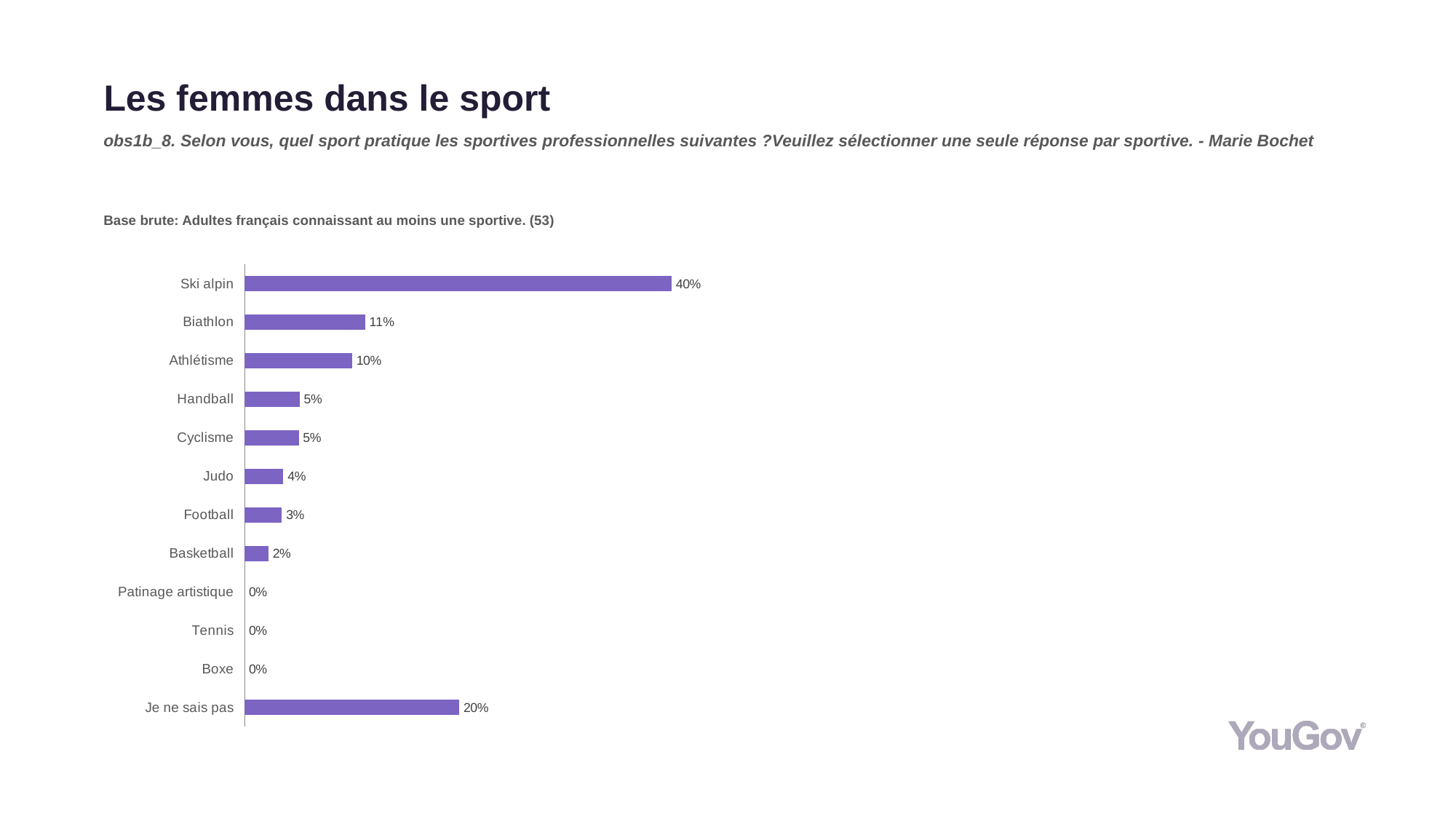
What kind of chart is shown on the slide? Bar chart What is the difference between the values for Ski alpin and Je ne sais pas? 20% What is the value for Judo? 4% What is the difference between the values for Biathlon and Athlétisme? 1% What is the value for Ski alpin? 40% What is the value for Je ne sais pas? 20% Which category has the highest value? Ski alpin Which is larger, the value for Football or the value for Basketball? Football How many categories have a value of 0%? 3 What is the title of the slide? Les femmes dans le sport What is the value for Biathlon? 11% How many categories are shown on the chart? 12